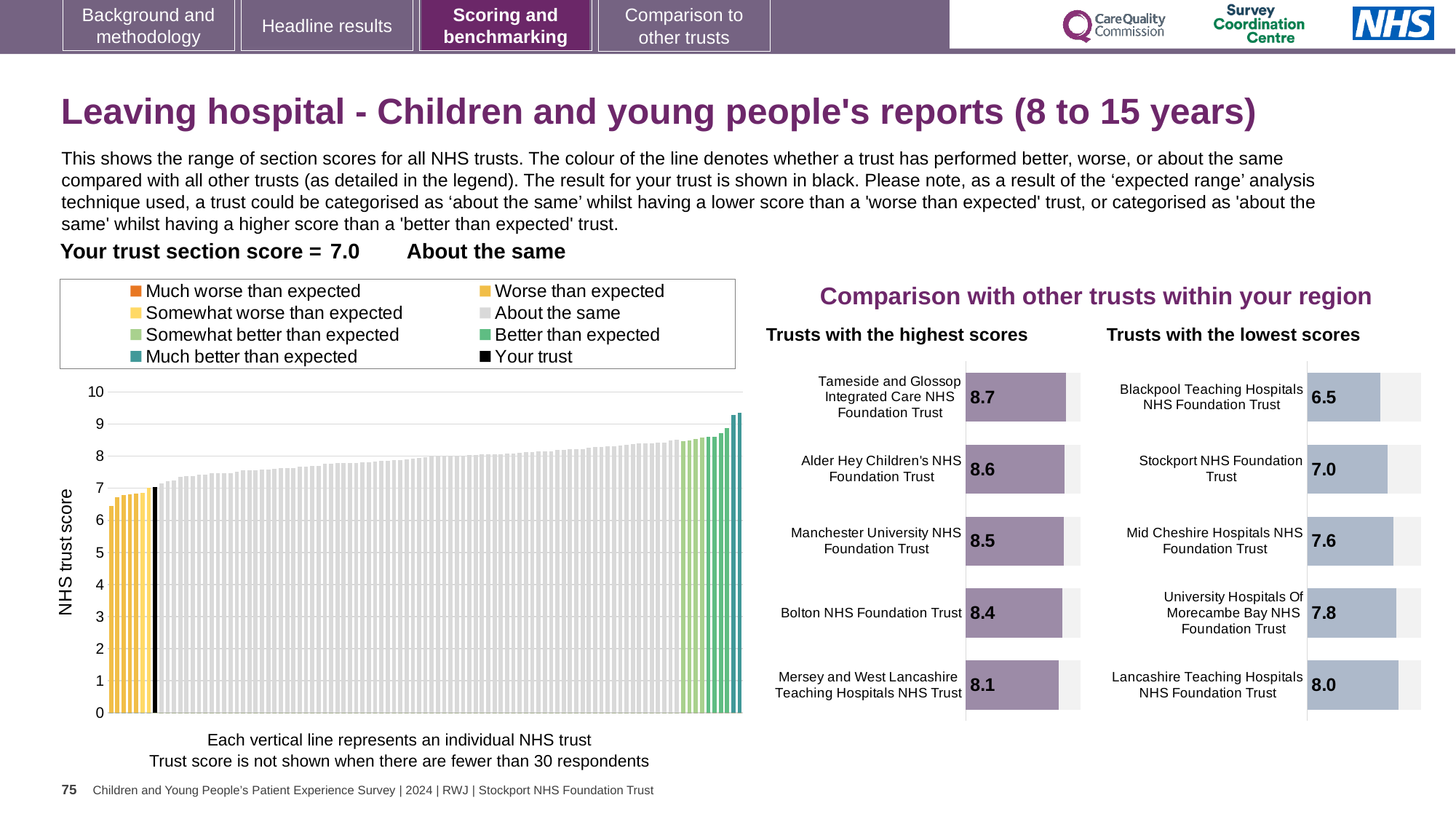
In the 'Trusts with the highest scores' chart, which trust has the lowest score? Mersey and West Lancashire Teaching Hospitals NHS Trust In the 'Trusts with the lowest scores' chart, which has the larger score: Stockport NHS Foundation Trust or Mid Cheshire Hospitals NHS Foundation Trust? Mid Cheshire Hospitals NHS Foundation Trust In the 'Trusts with the highest scores' chart, what is the difference between the scores of Tameside and Glossop Integrated Care NHS Foundation Trust and Bolton NHS Foundation Trust? 0.3 In the 'Trusts with the highest scores' chart, what is the score for Tameside and Glossop Integrated Care NHS Foundation Trust? 8.7 How many trusts are shown in the 'Trusts with the lowest scores' chart? 5 In the 'Trusts with the lowest scores' chart, what is the score for University Hospitals Of Morecambe Bay NHS Foundation Trust? 7.8 In the 'Trusts with the lowest scores' chart, which trust has the highest score? Lancashire Teaching Hospitals NHS Foundation Trust In the 'Trusts with the lowest scores' chart, what is the score for Blackpool Teaching Hospitals NHS Foundation Trust? 6.5 In the large chart on the left, is the value of the tallest bar greater or less than 9? greater What kind of chart is the large chart on the left showing NHS trust scores? Bar chart In the large chart on the left, do the trust scores rise or fall from left to right? Rise How many entries does the legend of the large chart on the left list? 8